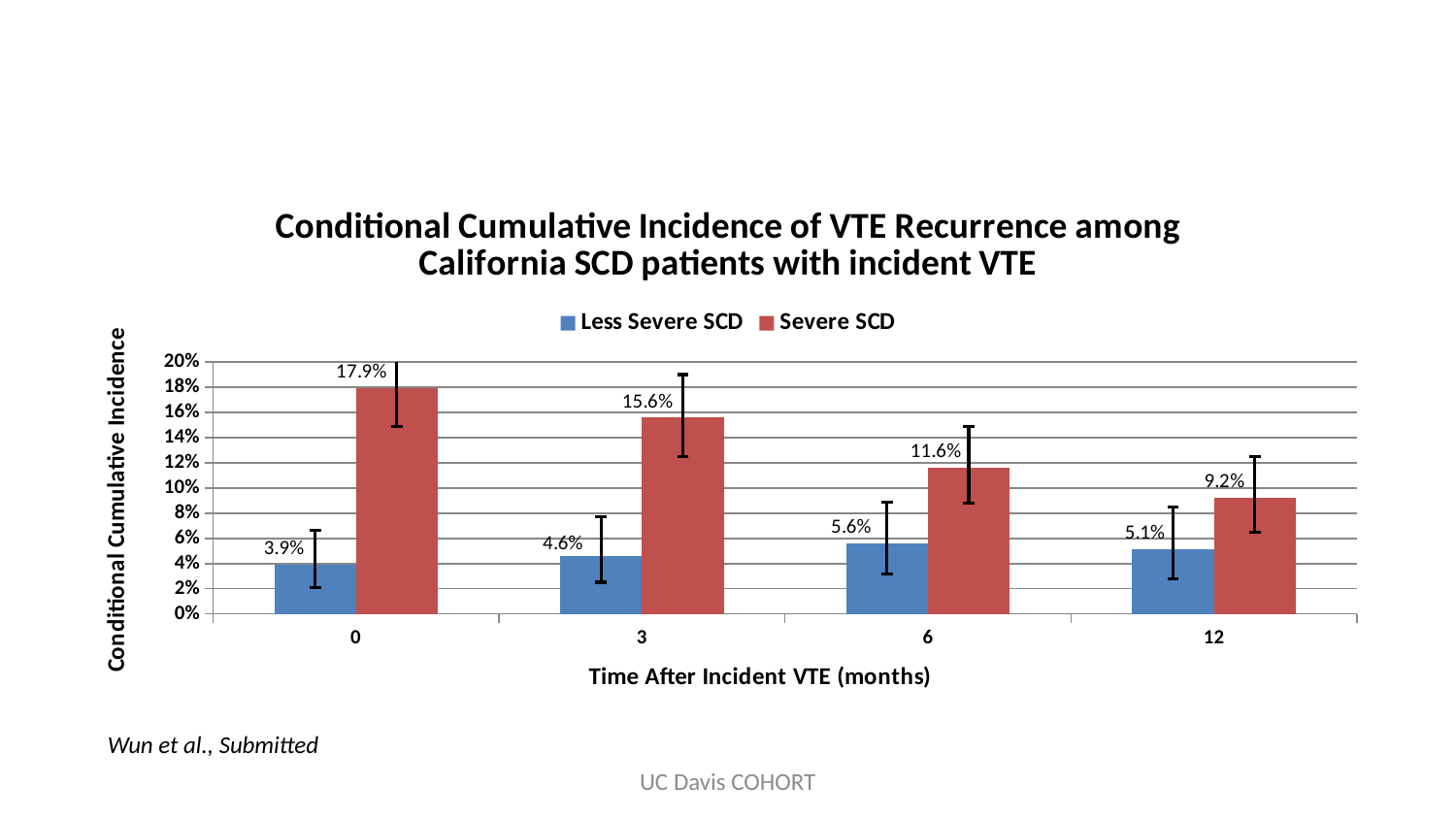
What is the value for Severe SCD at 0 months? 17.9% Do the Severe SCD values rise or fall from 0 to 12 months? fall Which is larger at 12 months: Severe SCD or Less Severe SCD? Severe SCD How many series does the legend list? 2 At which time point is the Severe SCD value highest? 0 What kind of chart is this? bar chart What is the difference between the Severe SCD and Less Severe SCD values at 3 months? 11.0% What is the label of the x axis? Time After Incident VTE (months) At which time point is the Less Severe SCD value lowest? 0 How many time points are shown on the x axis? 4 What is the value for Severe SCD at 12 months? 9.2% What is the value for Less Severe SCD at 6 months? 5.6%